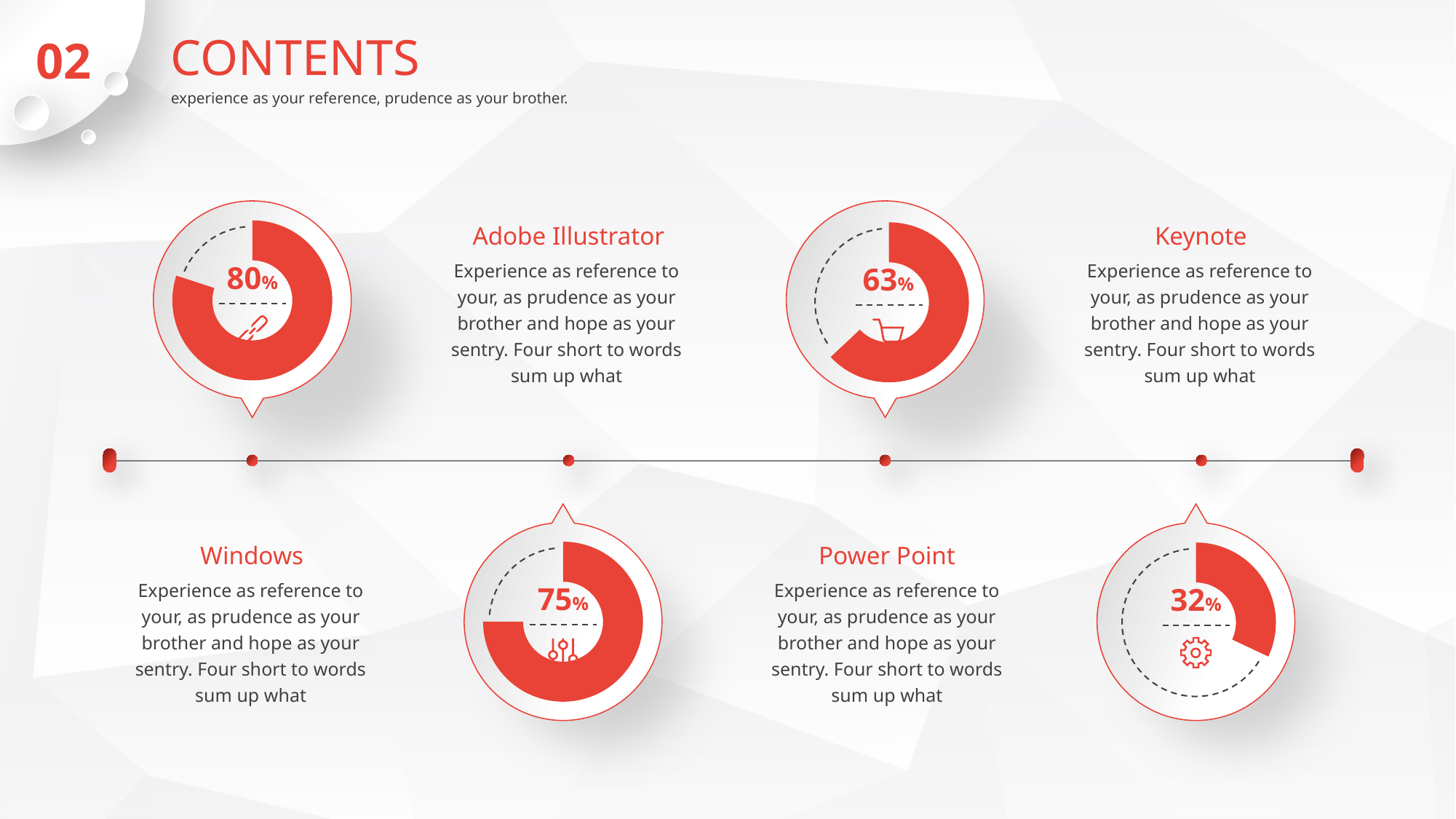
What is the difference between the Adobe Illustrator percentage and the Power Point percentage? 48% What is the difference between the Windows percentage and the Keynote percentage? 12% What percentage is shown in the Power Point donut chart? 32% What kind of chart is used to show the Keynote percentage? Donut chart What percentage is shown in the Adobe Illustrator donut chart? 80% What percentage is shown in the Windows donut chart? 75% Across the four donut charts on the slide, which item has the highest percentage? Adobe Illustrator Which is larger, the Keynote percentage or the Windows percentage? Windows How many donut charts are shown on the slide? 4 Across the four donut charts on the slide, which item has the lowest percentage? Power Point What colour is the filled portion of the donut charts on the slide? Red What percentage is shown in the Keynote donut chart? 63%